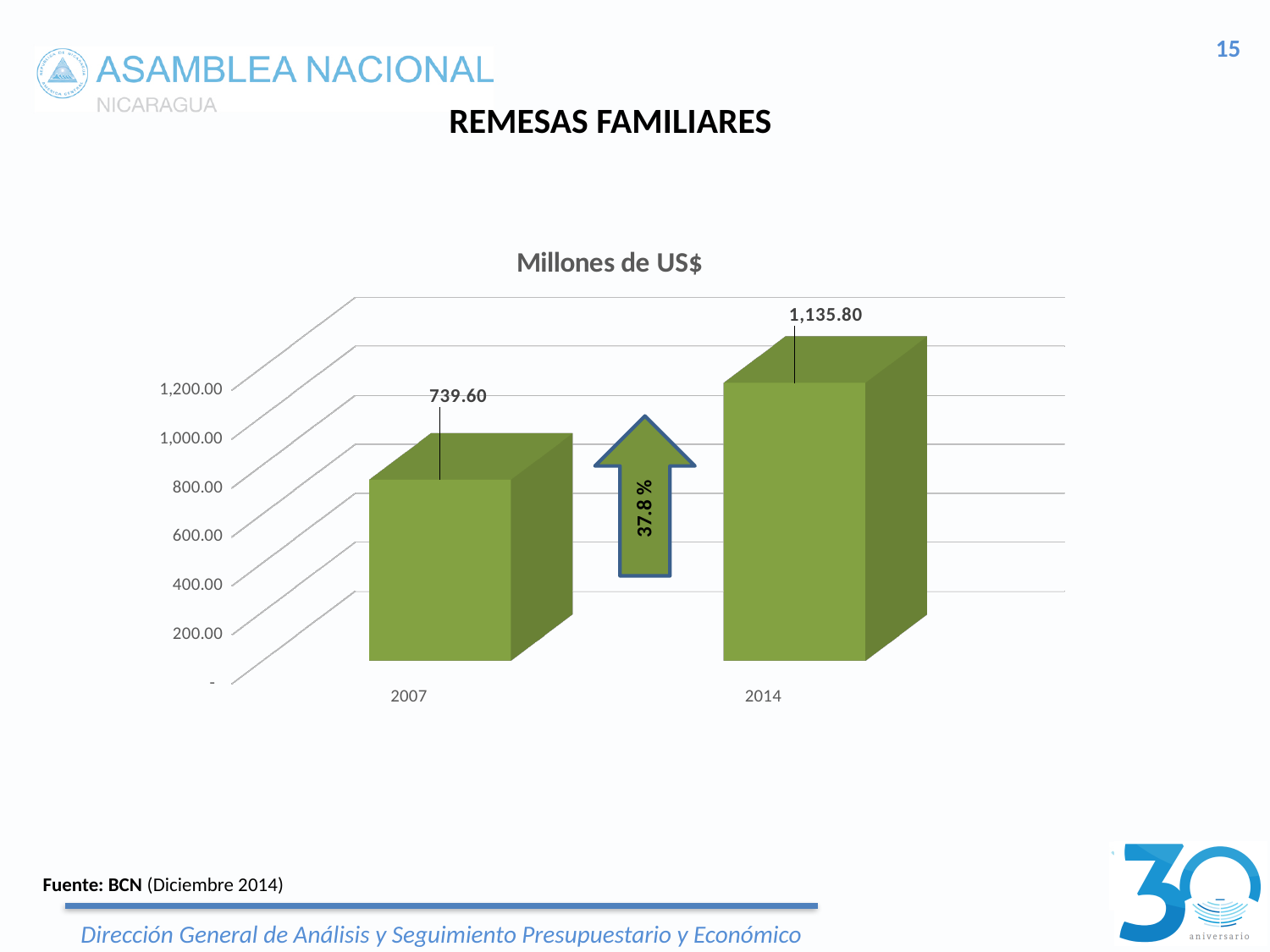
What is the value for 2007? 739.60 Which year has the higher value? 2014 Is the value for 2007 greater or less than 800.00? less What is the difference between the 2014 and 2007 values? 396.20 What percentage increase is shown on the arrow between the bars? 37.8 % Is the value for 2014 larger than the value for 2007? Yes Is the value for 2014 greater or less than 1,000.00? greater Which year has the lower value? 2007 How many years are shown on the chart? 2 Do the values rise or fall from 2007 to 2014? Rise What kind of chart is shown? Bar chart What is the value for 2014? 1,135.80